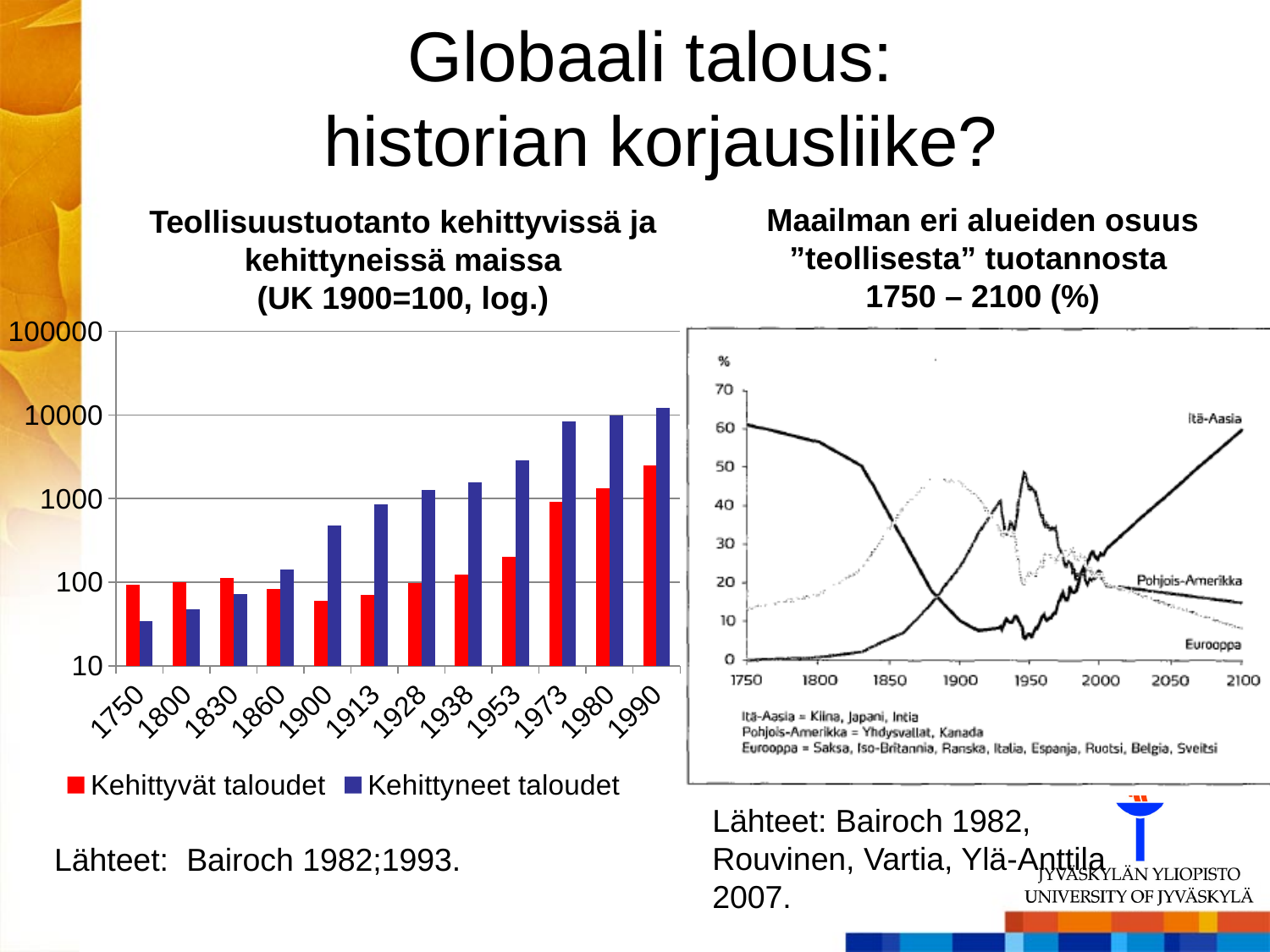
In the left bar chart, is the value for Kehittyneet taloudet in 1900 greater or less than 1000? less How many series does the legend of the left bar chart list? 2 In the left bar chart, for which year is the value for Kehittyneet taloudet lowest? 1750 What kind of chart is the left chart, 'Teollisuustuotanto kehittyvissä ja kehittyneissä maissa'? bar chart In the right line chart, which region has the highest share in 1750? Itä-Aasia In the left bar chart, do the values for Kehittyneet taloudet generally rise or fall from 1750 to 1990? rise In the left bar chart, for which year is the value for Kehittyneet taloudet highest? 1990 What kind of chart is the right chart, 'Maailman eri alueiden osuus "teollisesta" tuotannosta 1750 – 2100 (%)'? line chart In the left bar chart, which series is shown in red? Kehittyvät taloudet How many years (categories) are shown on the x axis of the left bar chart? 12 In the left bar chart, is the value for Kehittyvät taloudet in 1990 greater or less than 1000? greater In the left bar chart, which series has the larger value in 1750, Kehittyvät taloudet or Kehittyneet taloudet? Kehittyvät taloudet